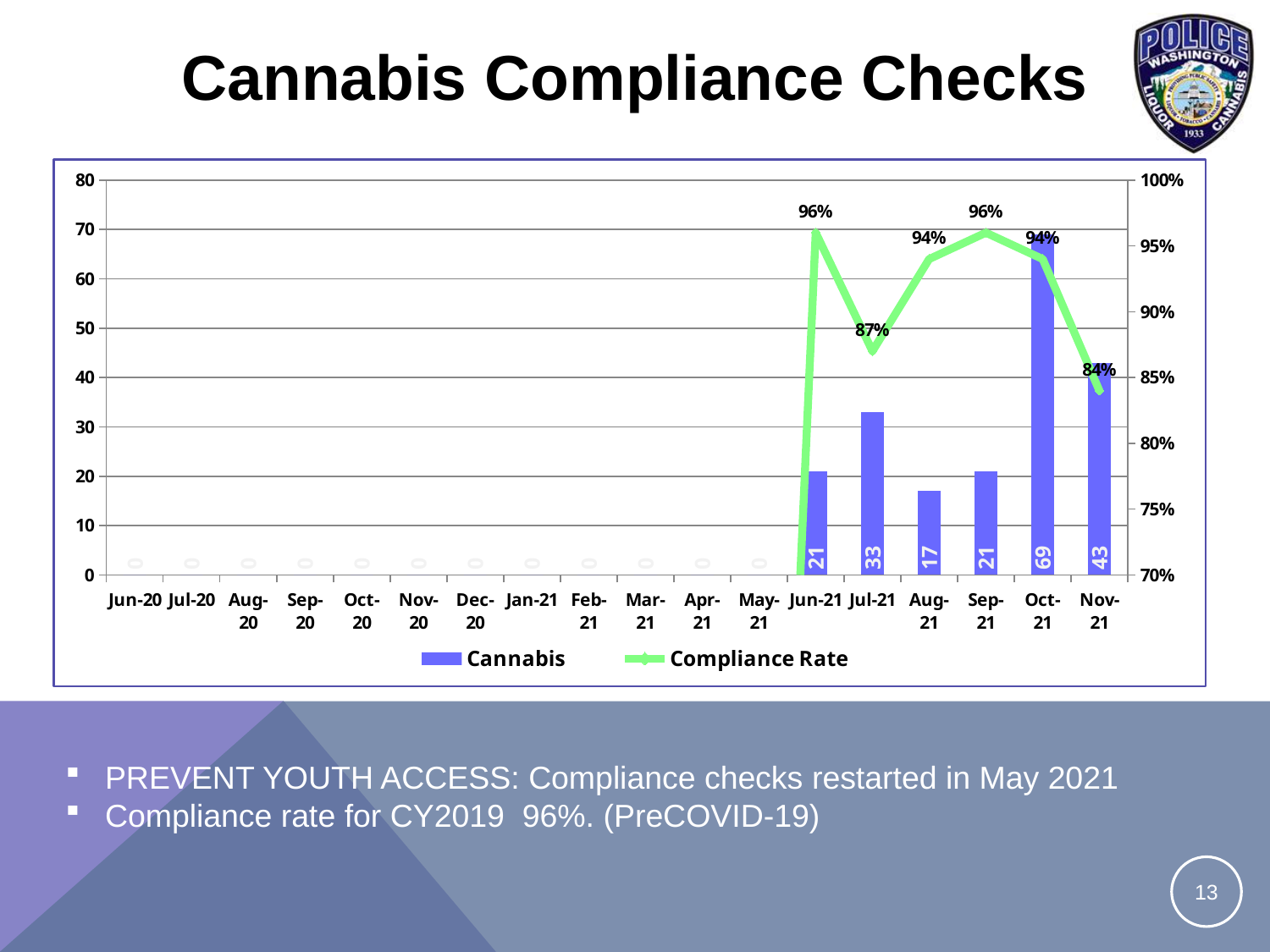
Which month has the lowest Compliance Rate shown? Nov-21 How many series does the legend list? 2 What is the Compliance Rate for Nov-21? 84% What is the Cannabis value for Oct-21? 69 What is the Compliance Rate for Jul-21? 87% What is the title of the slide containing the chart? Cannabis Compliance Checks What is the Cannabis value for Aug-21? 17 What is the difference between the Cannabis values for Oct-21 and Nov-21? 26 Which is larger, the Cannabis value for Jul-21 or for Sep-21? Jul-21 How many months are shown on the x axis? 18 Does the Compliance Rate rise or fall from Oct-21 to Nov-21? fall Which month has the highest Cannabis value? Oct-21